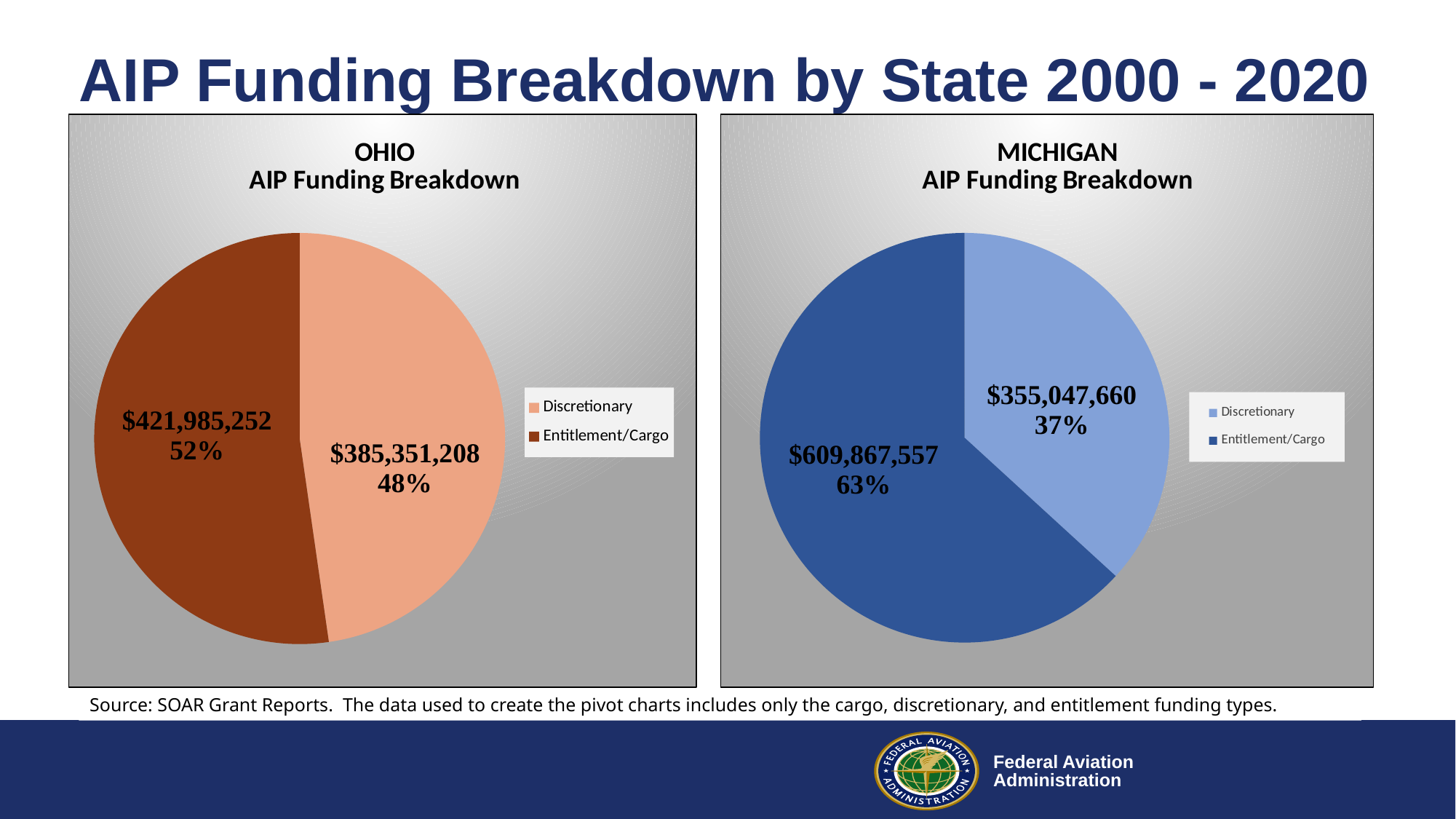
In the OHIO AIP Funding Breakdown chart, what is the value for Entitlement/Cargo? $421,985,252 In the MICHIGAN AIP Funding Breakdown chart, which category is the largest? Entitlement/Cargo In the OHIO AIP Funding Breakdown chart, which category is the smallest? Discretionary In the OHIO AIP Funding Breakdown chart, what is the value for Discretionary? $385,351,208 What kind of chart is the MICHIGAN AIP Funding Breakdown chart? Pie chart In the MICHIGAN AIP Funding Breakdown chart, what is the value for Entitlement/Cargo? $609,867,557 In the OHIO AIP Funding Breakdown chart, what share of the pie is Entitlement/Cargo? 52% In the MICHIGAN AIP Funding Breakdown chart, what share of the pie is Discretionary? 37% How many entries does the legend of the OHIO AIP Funding Breakdown chart list? 2 In the OHIO AIP Funding Breakdown chart, what is the difference between Entitlement/Cargo and Discretionary? $36,634,044 In the MICHIGAN AIP Funding Breakdown chart, what is the difference between Entitlement/Cargo and Discretionary? $254,819,897 In the MICHIGAN AIP Funding Breakdown chart, what is the value for Discretionary? $355,047,660